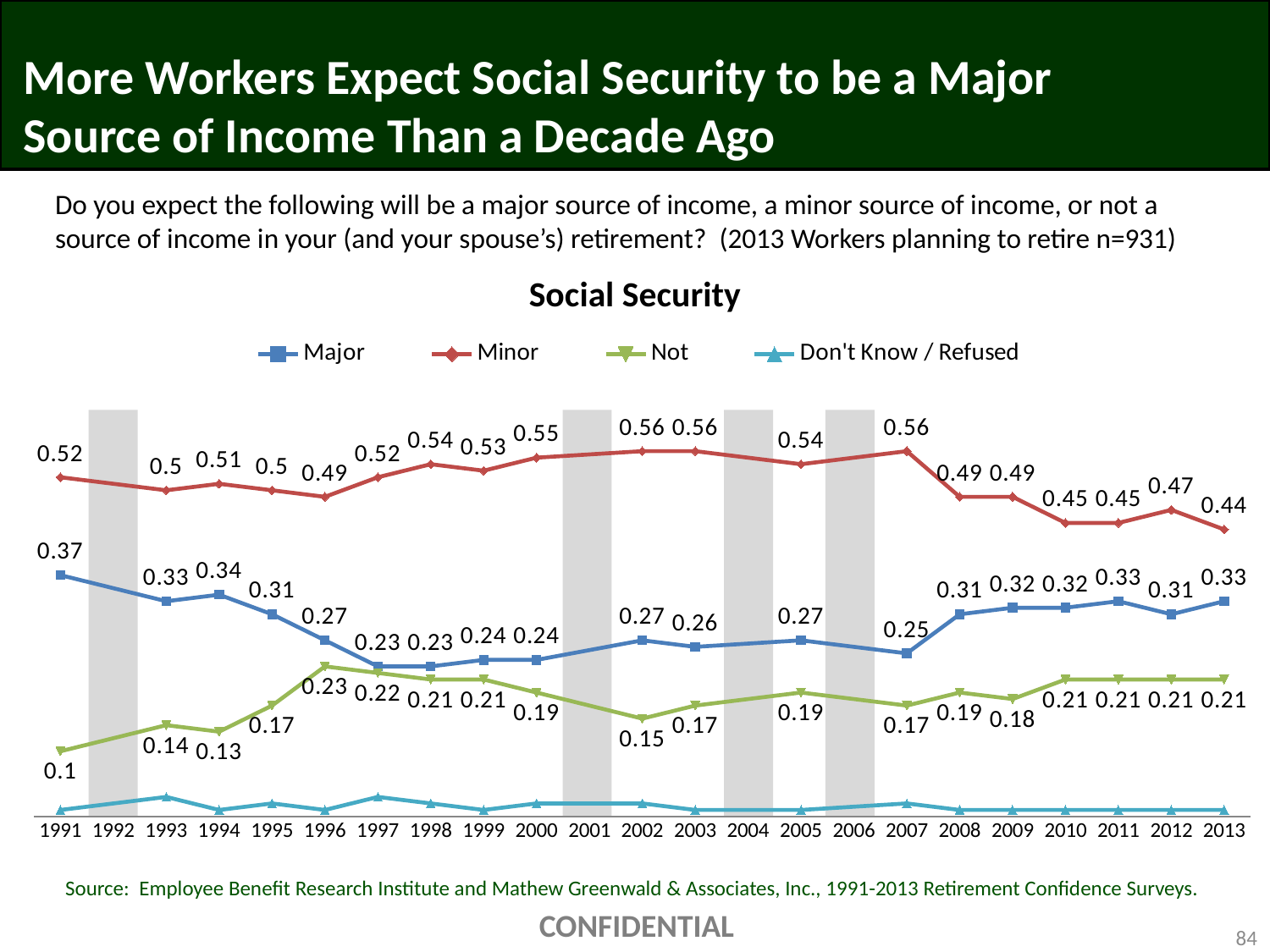
How many series does the legend of the Social Security chart list? 4 What is the value for the Not series in 1991? 0.1 What is the title of the chart? Social Security What is the value for the Minor series in 1991? 0.52 What is the difference between the Minor value in 1991 and the Minor value in 2013? 0.08 In which year does the Major series reach its highest value? 1991 What kind of chart is shown on the slide? line chart In 2013, which series has the larger value, Major or Not? Major What is the lowest value shown for the Not series? 0.1 What is the value for the Minor series in 2013? 0.44 How many years are shown on the x axis of the chart? 23 What is the value for the Major series in 2013? 0.33